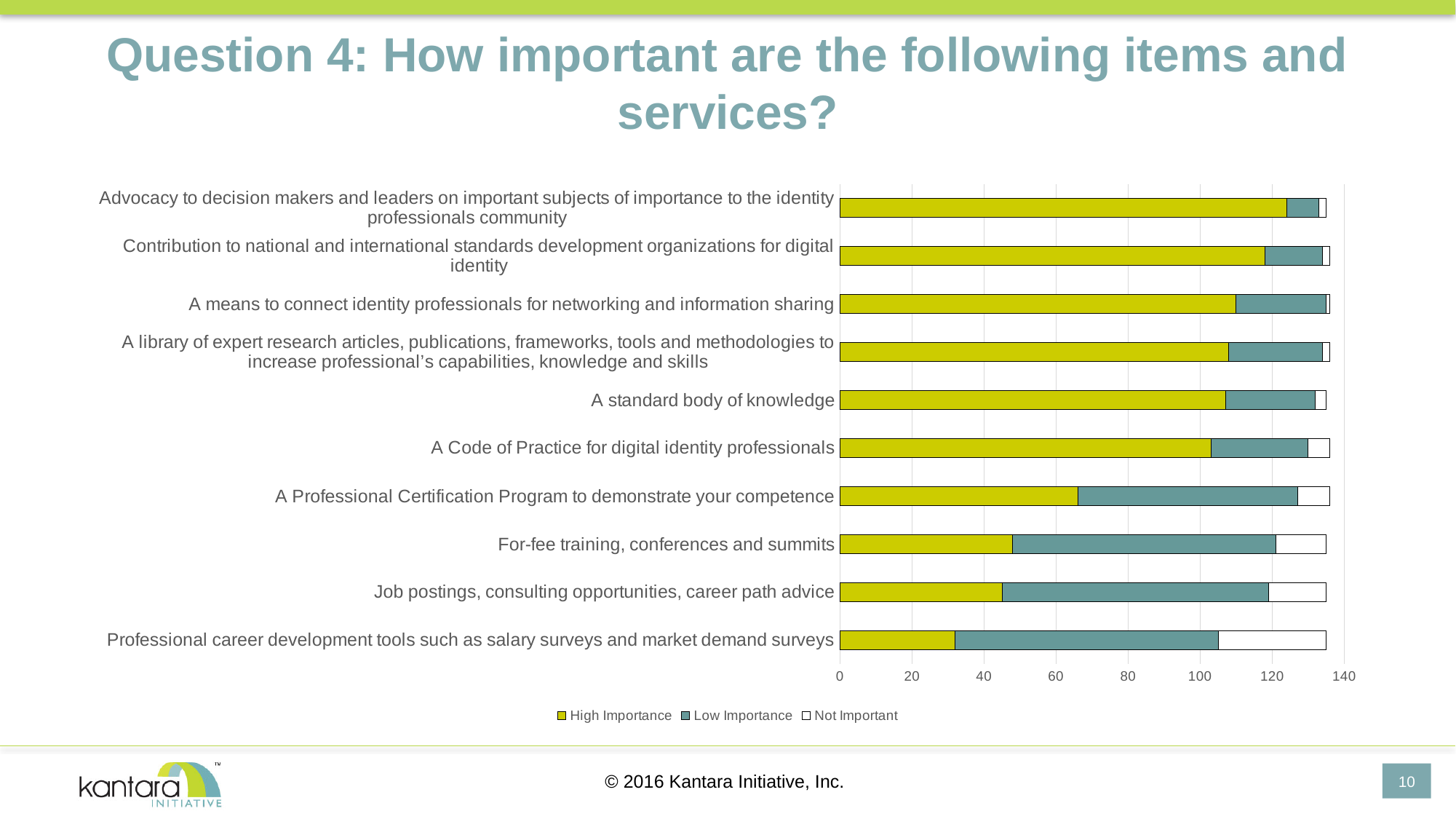
What kind of chart is shown on the slide? Stacked bar chart Which item has the largest High Importance value? Advocacy to decision makers and leaders on important subjects of importance to the identity professionals community Is the High Importance value for 'A Professional Certification Program to demonstrate your competence' greater or less than 60? greater Which has the larger High Importance value: 'A standard body of knowledge' or 'For-fee training, conferences and summits'? A standard body of knowledge How many series does the legend list? 3 Is the High Importance value for 'Advocacy to decision makers and leaders...' greater or less than 120? greater What are the three series named in the legend? High Importance, Low Importance, Not Important Which item has the largest Not Important value? Professional career development tools such as salary surveys and market demand surveys How many items or services are listed as categories in the chart? 10 Which item has the smallest High Importance value? Professional career development tools such as salary surveys and market demand surveys Is the High Importance value for 'Professional career development tools such as salary surveys and market demand surveys' greater or less than 40? less